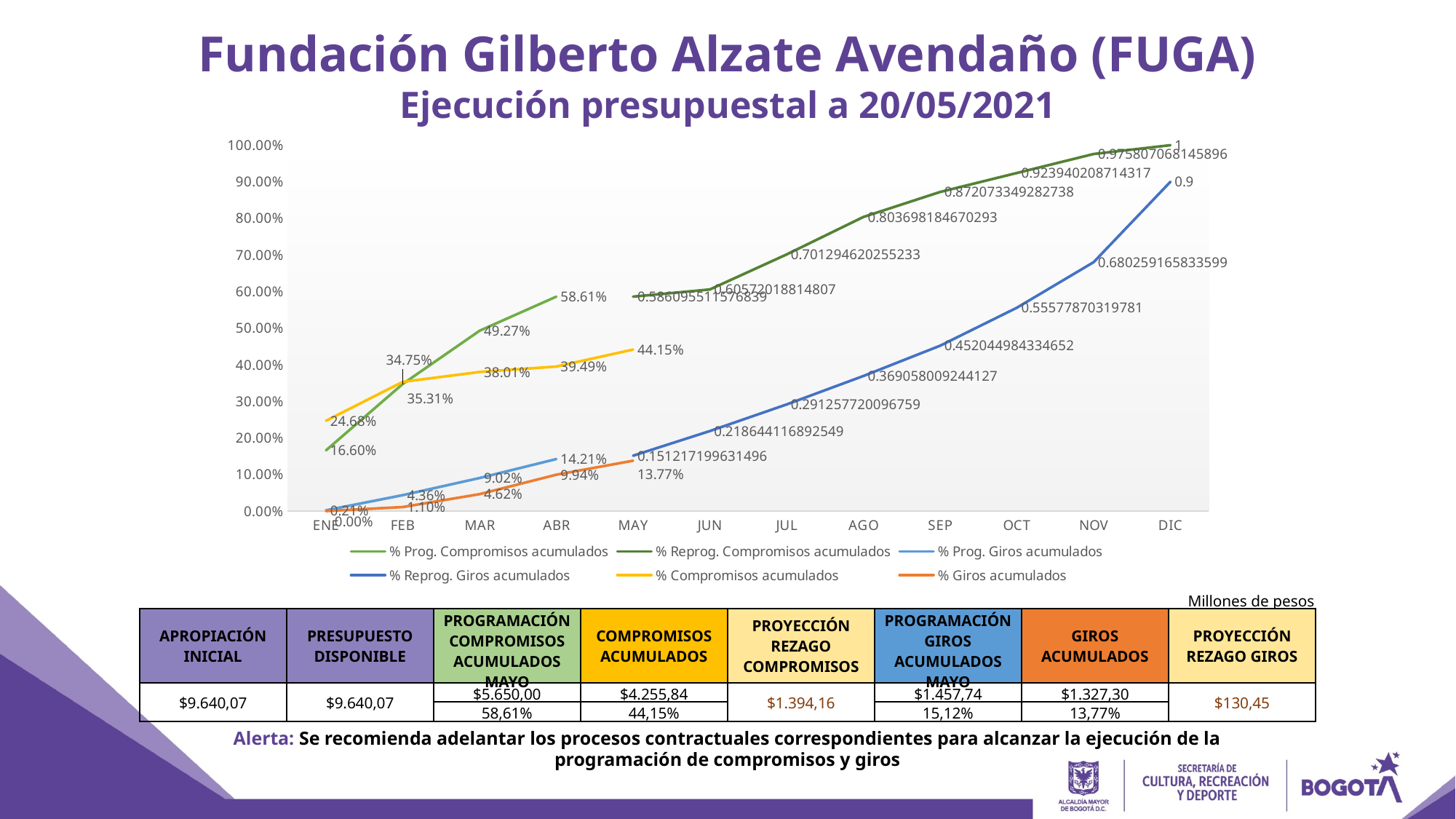
What is the value of % Prog. Compromisos acumulados in ABR? 58.61% Does the % Reprog. Giros acumulados series rise or fall from MAY to DIC? rise What is the difference between % Prog. Compromisos acumulados and % Compromisos acumulados in ABR? 19.12% How many months are shown on the x axis of the chart? 12 What type of chart is shown on the slide? line chart Which is larger in FEB: % Compromisos acumulados or % Prog. Compromisos acumulados? % Compromisos acumulados How many series does the chart legend list? 6 What is the value of % Reprog. Giros acumulados in DIC? 0.9 What is the value of % Giros acumulados in MAY? 13.77% What is the value of % Compromisos acumulados in MAY? 44.15% In which month does % Reprog. Compromisos acumulados reach its highest value? DIC What is the value of % Prog. Giros acumulados in ABR? 14.21%